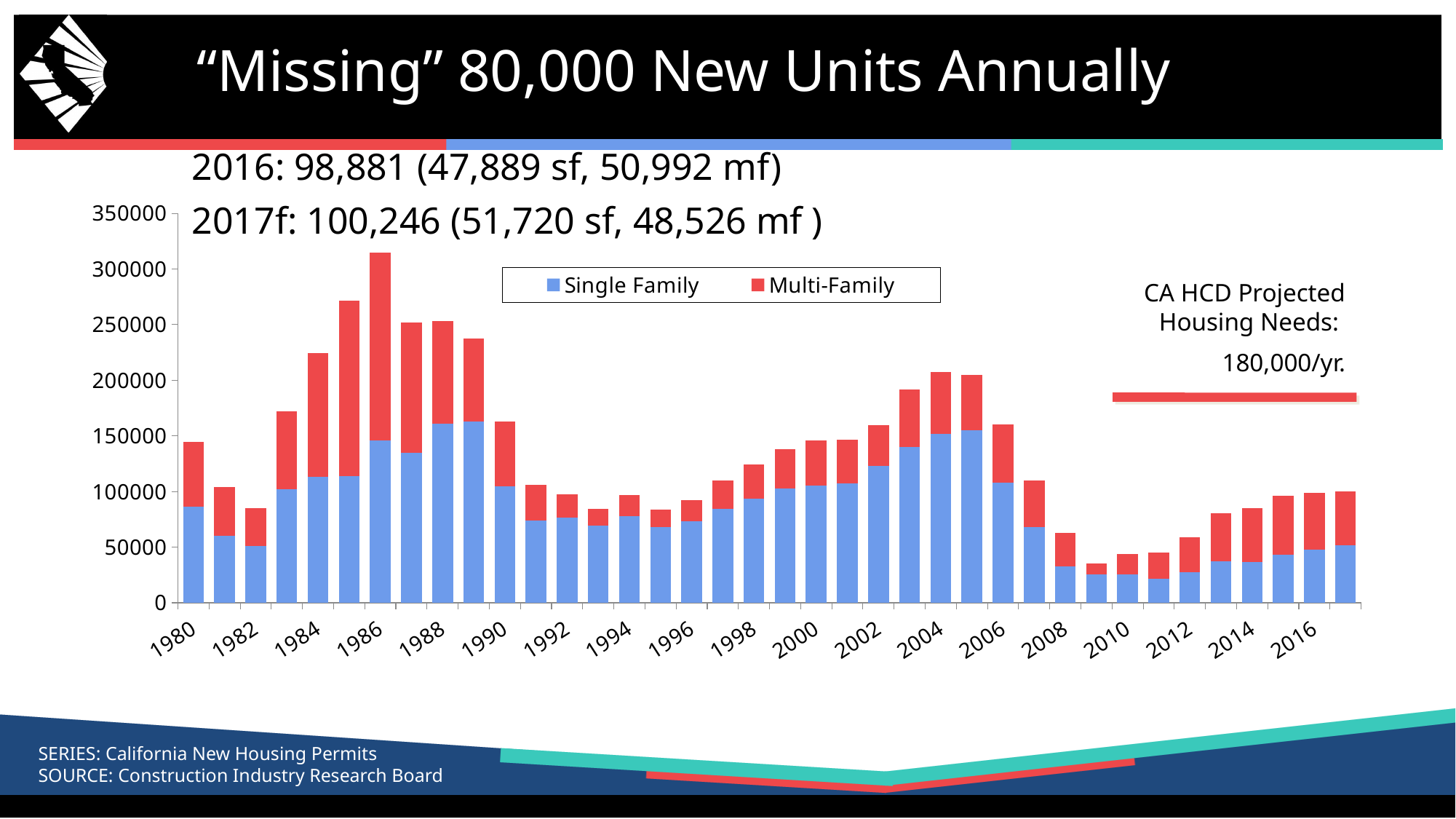
Is the total value for 1986 greater or less than 300000? greater According to the text on the slide, what is the total number of new housing permits for 2016? 98,881 Do the total values rise or fall from 2009 to 2017? Rise Is the total value for 2009 greater or less than 50000? less What kind of chart is shown on the slide? Stacked bar chart Which year has the lowest total number of new housing permits? 2009 Is the total value for 1995 greater or less than 100000? less According to the text on the slide, what is the single-family value for 2017f? 51,720 How many series does the legend list? 2 What are the two series named in the legend? Single Family and Multi-Family Which year has the larger total, 1986 or 2005? 1986 Which year has the highest total number of new housing permits? 1986